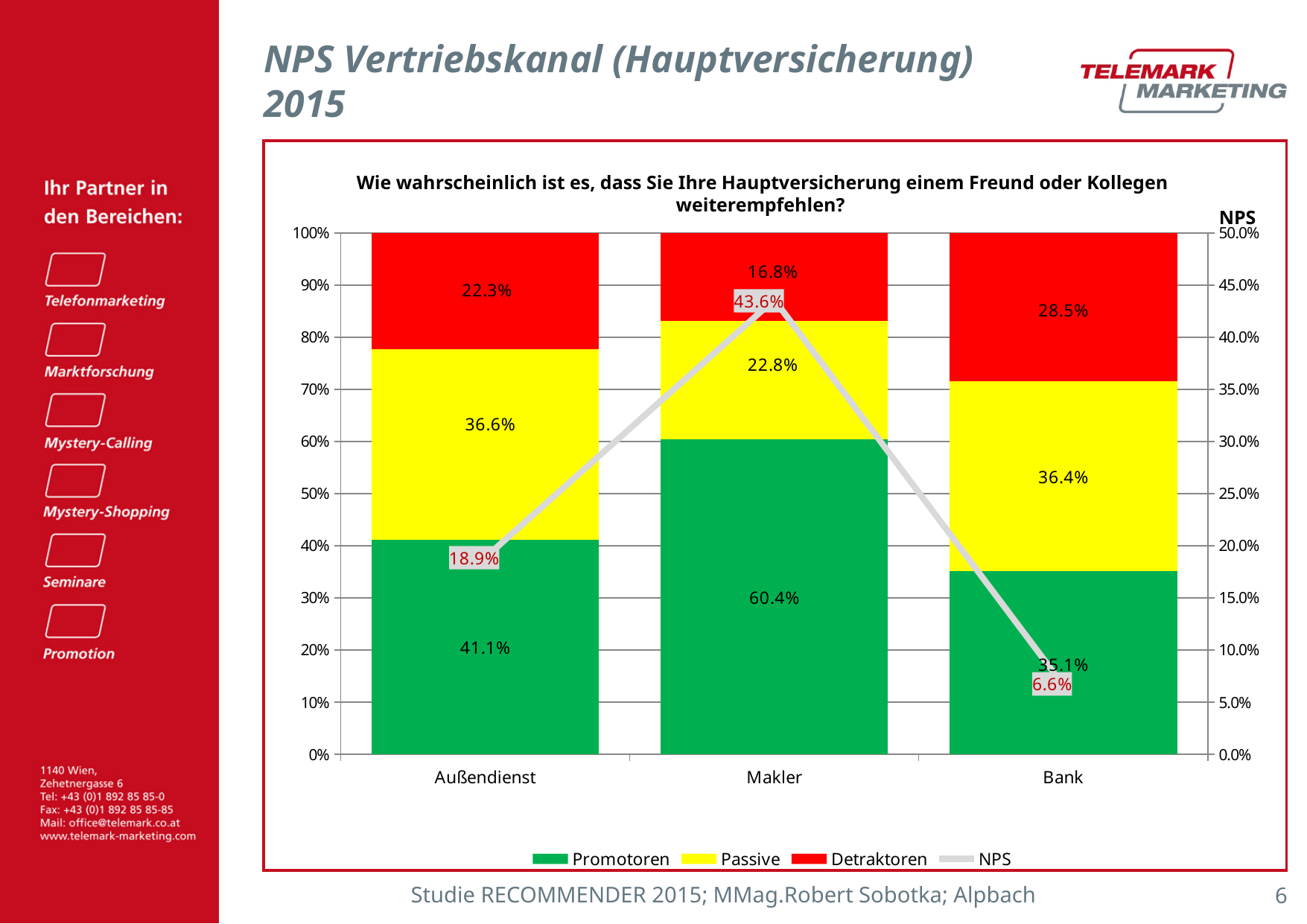
Which colour represents Passive in the chart? Yellow Which is larger, the Detraktoren share for Bank or the Detraktoren share for Makler? Bank What is the Passive share for Bank? 36.4% How many series does the legend list? 4 What is the difference between the NPS for Makler and the NPS for Außendienst? 24.7% How many categories are shown on the x axis? 3 What is the NPS value for Bank? 6.6% Which category has the lowest Promotoren share? Bank Which category has the highest NPS? Makler What kind of chart is this? Stacked bar chart with a line What is the Detraktoren share for Außendienst? 22.3% What is the Promotoren share for Makler? 60.4%